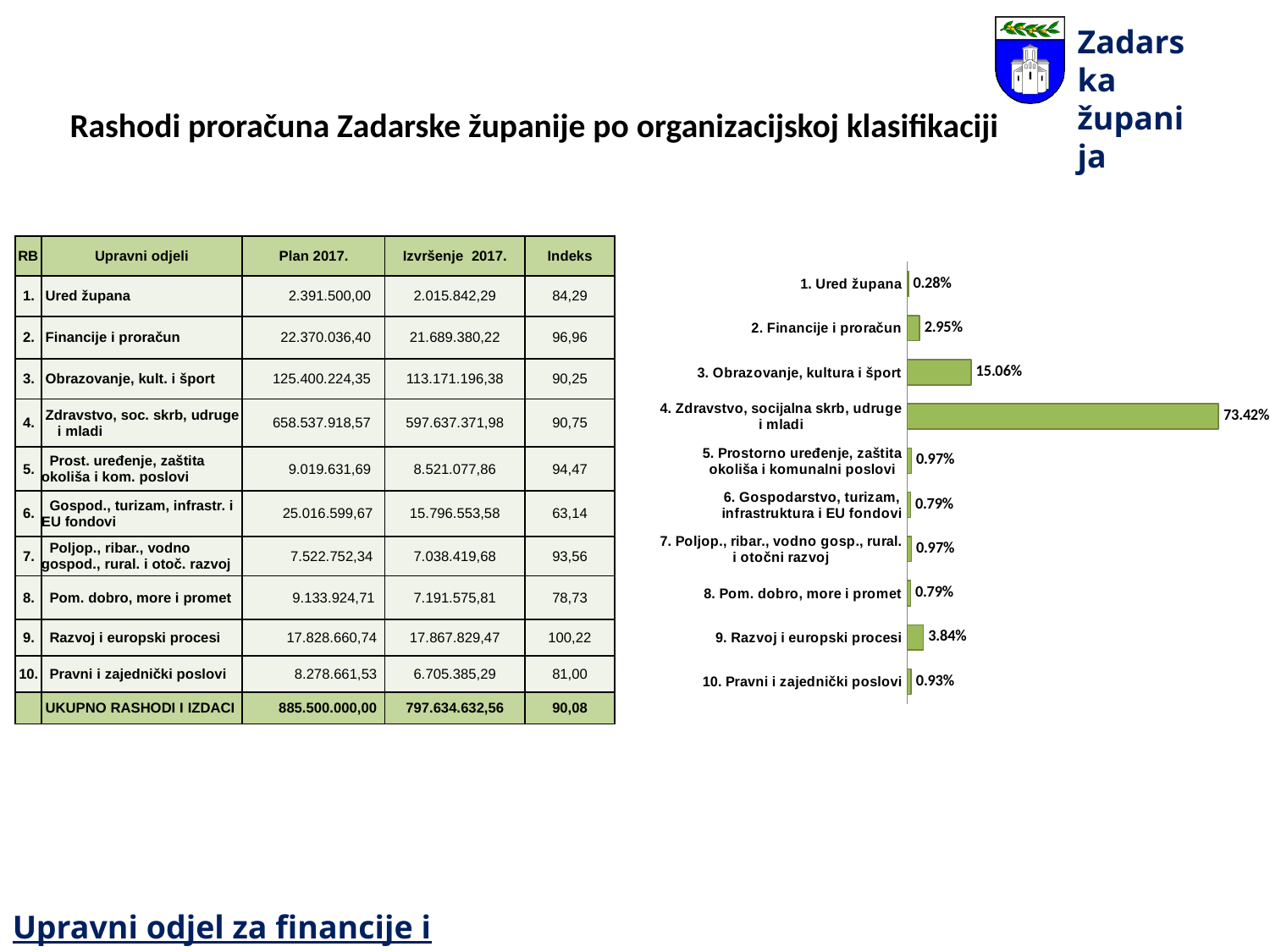
Which has the larger value: "9. Razvoj i europski procesi" or "2. Financije i proračun"? 9. Razvoj i europski procesi How many categories does the bar chart show? 10 What kind of chart is shown on the slide? bar chart What is the difference between the values for "4. Zdravstvo, socijalna skrb, udruge i mladi" and "3. Obrazovanje, kultura i šport"? 58.36% Which category has the highest value in the bar chart? 4. Zdravstvo, socijalna skrb, udruge i mladi What is the difference between the values for "3. Obrazovanje, kultura i šport" and "9. Razvoj i europski procesi"? 11.22% What is the value shown for "9. Razvoj i europski procesi"? 3.84% What is the value shown for "1. Ured župana"? 0.28% Which category has the lowest value in the bar chart? 1. Ured župana What is the value shown for "3. Obrazovanje, kultura i šport"? 15.06% What is the value shown for "10. Pravni i zajednički poslovi"? 0.93% What is the value shown for "4. Zdravstvo, socijalna skrb, udruge i mladi"? 73.42%